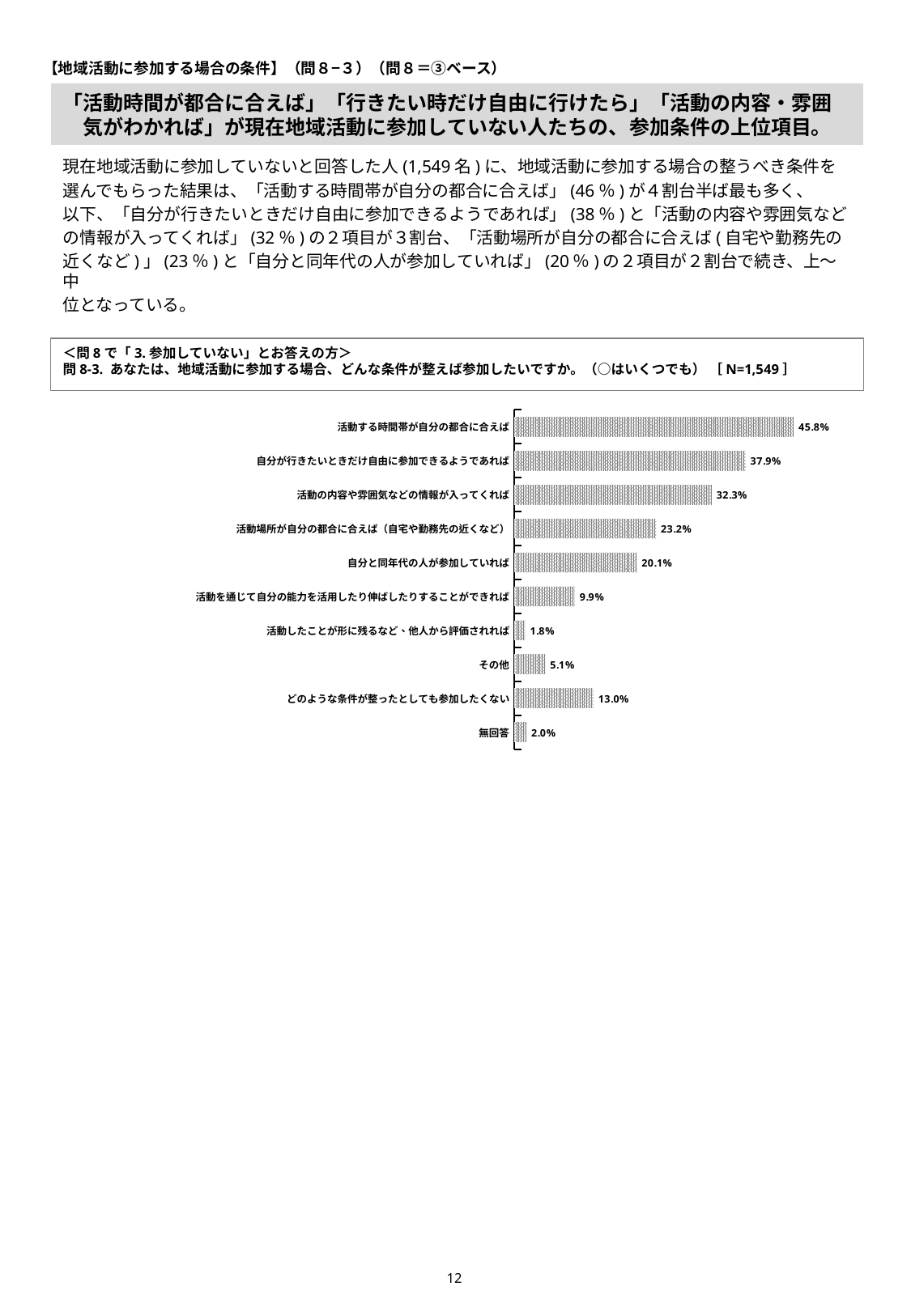
Which category has the lowest value? 活動したことが形に残るなど、他人から評価されれば What is the value for 無回答? 2.0% Which is larger: 活動場所が自分の都合に合えば（自宅や勤務先の近くなど） or 自分と同年代の人が参加していれば? 活動場所が自分の都合に合えば（自宅や勤務先の近くなど） What is the value for 活動する時間帯が自分の都合に合えば? 45.8% What is the difference between 活動する時間帯が自分の都合に合えば and 自分が行きたいときだけ自由に参加できるようであれば? 7.9% How many categories are shown in the chart? 10 What is the value for どのような条件が整ったとしても参加したくない? 13.0% Which category has the highest value? 活動する時間帯が自分の都合に合えば What is the value for 活動の内容や雰囲気などの情報が入ってくれば? 32.3% What is the difference between その他 and 無回答? 3.1% What kind of chart is shown? bar chart What is the N (sample size) shown for the chart? N=1,549